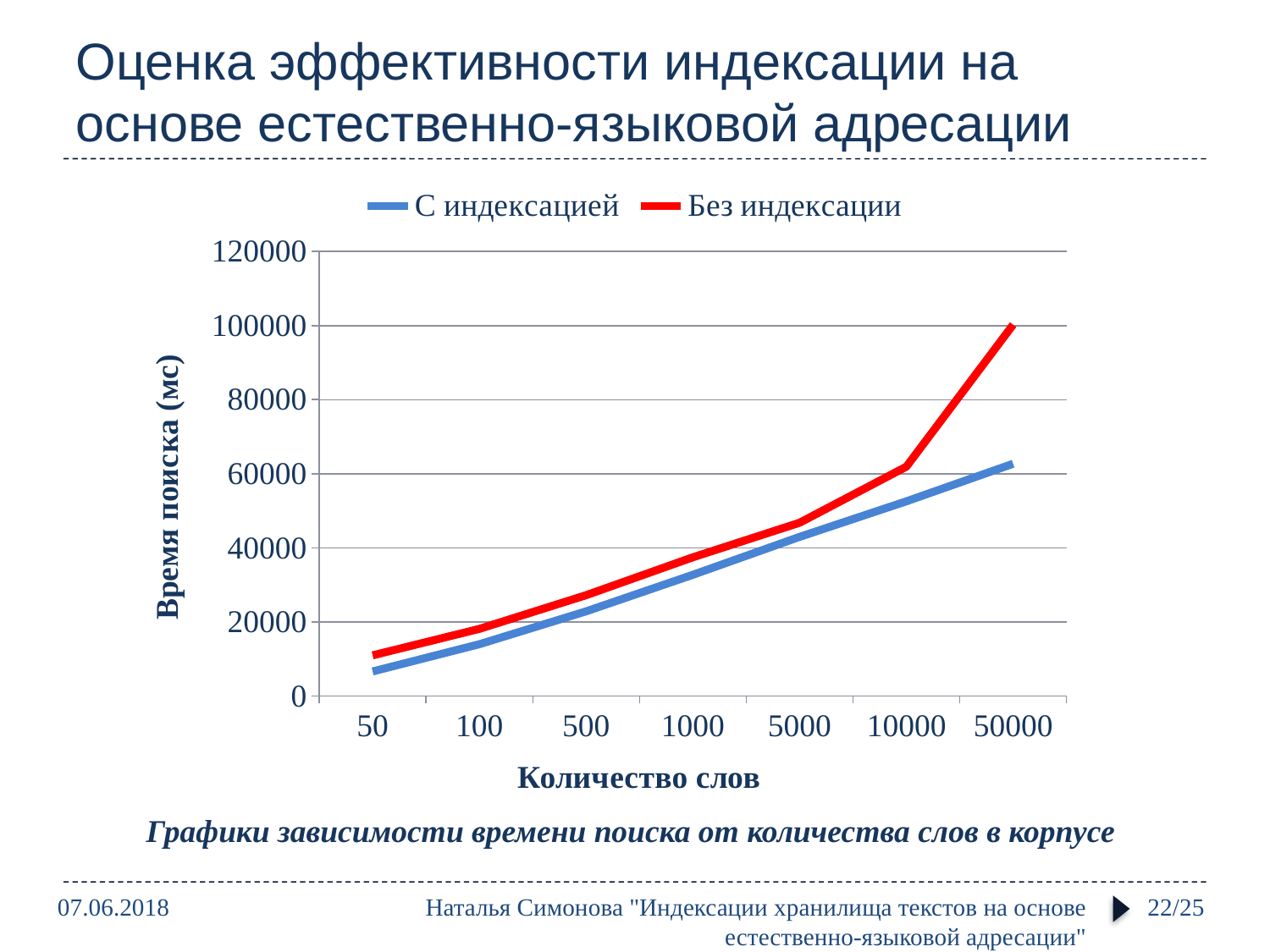
Is the value for С индексацией at 50 words greater or less than 20000? less Which series has the higher value at 50000 words? Без индексации Is the value for Без индексации at 50000 words greater or less than 80000? greater At which number of words does the Без индексации series reach its highest value? 50000 How many series does the legend list? 2 Is the value for С индексацией at 50000 words greater or less than 80000? less What kind of chart is shown on the slide? line chart How many points are plotted along the x axis (Количество слов)? 7 At which number of words is the С индексацией series lowest? 50 Do the search times rise or fall as the number of words increases? rise